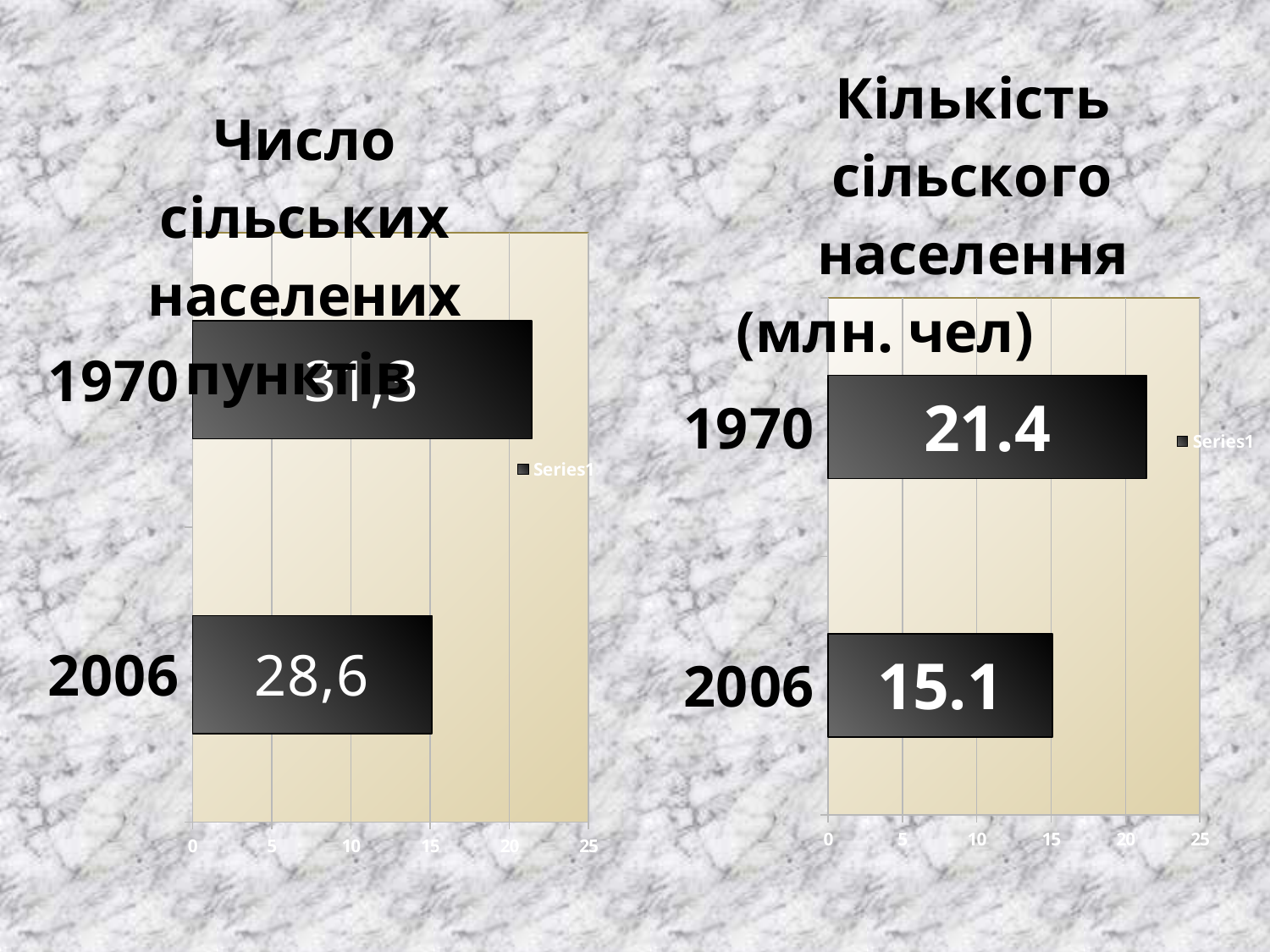
In the right chart (Кількість сільского населення), how many categories are shown? 2 In the right chart (Кількість сільского населення), is the value for 2006 greater or less than 20? less In the left chart (Число сільських населених пунктів), what is the highest value shown on the horizontal axis? 25 In the right chart (Кількість сільского населення), which year has the higher value? 1970 In the right chart (Кількість сільского населення), is the value for 1970 greater or less than 20? greater What type of chart is the right chart (Кількість сільского населення)? Bar chart In the right chart (Кількість сільского населення), what is the value for 2006? 15.1 In the right chart (Кількість сільского населення), which year has the lower value? 2006 In the right chart (Кількість сільского населення), what is the value for 1970? 21.4 In the right chart (Кількість сільского населення), how many series does the legend list? 1 In the left chart (Число сільських населених пунктів), what value is labelled on the 2006 bar? 28,6 In the right chart (Кількість сільского населення), what is the difference between the 1970 and 2006 values? 6.3